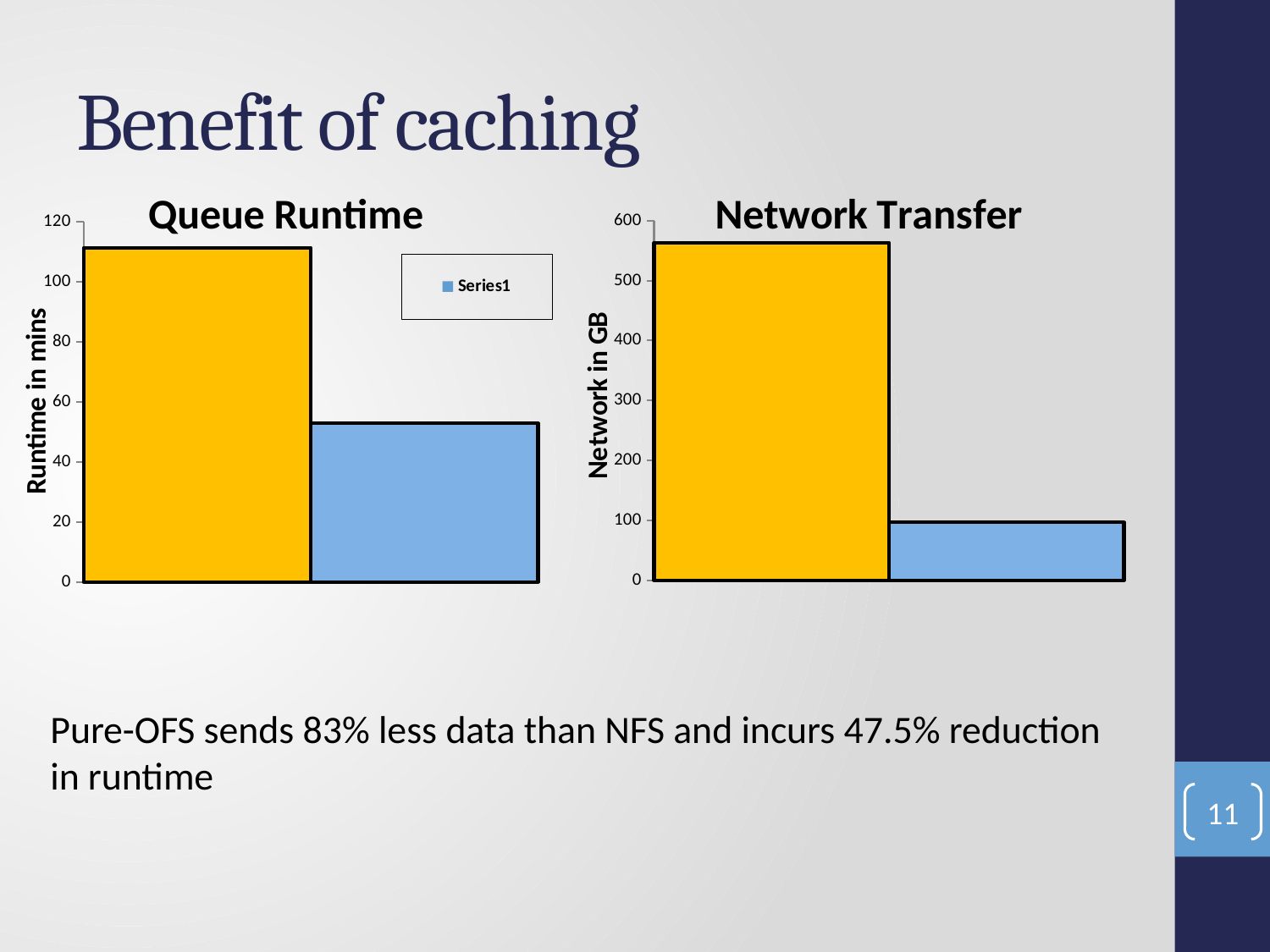
In the Queue Runtime chart, which bar is taller, the yellow (left) bar or the blue (right) bar? the yellow (left) bar What is the y-axis label of the Network Transfer chart? Network in GB In the Queue Runtime chart, is the value of the yellow (left) bar greater or less than 100? greater What kind of chart is the Queue Runtime chart? bar chart How many bars are plotted in the Network Transfer chart? 2 How many bars are plotted in the Queue Runtime chart? 2 In the Network Transfer chart, is the value of the blue (right) bar greater or less than 200? less What kind of chart is the Network Transfer chart? bar chart In the Queue Runtime chart, is the value of the blue (right) bar greater or less than 60? less In the Network Transfer chart, which bar is the lowest? the blue (right) bar How many entries does the legend in the Queue Runtime chart list? 1